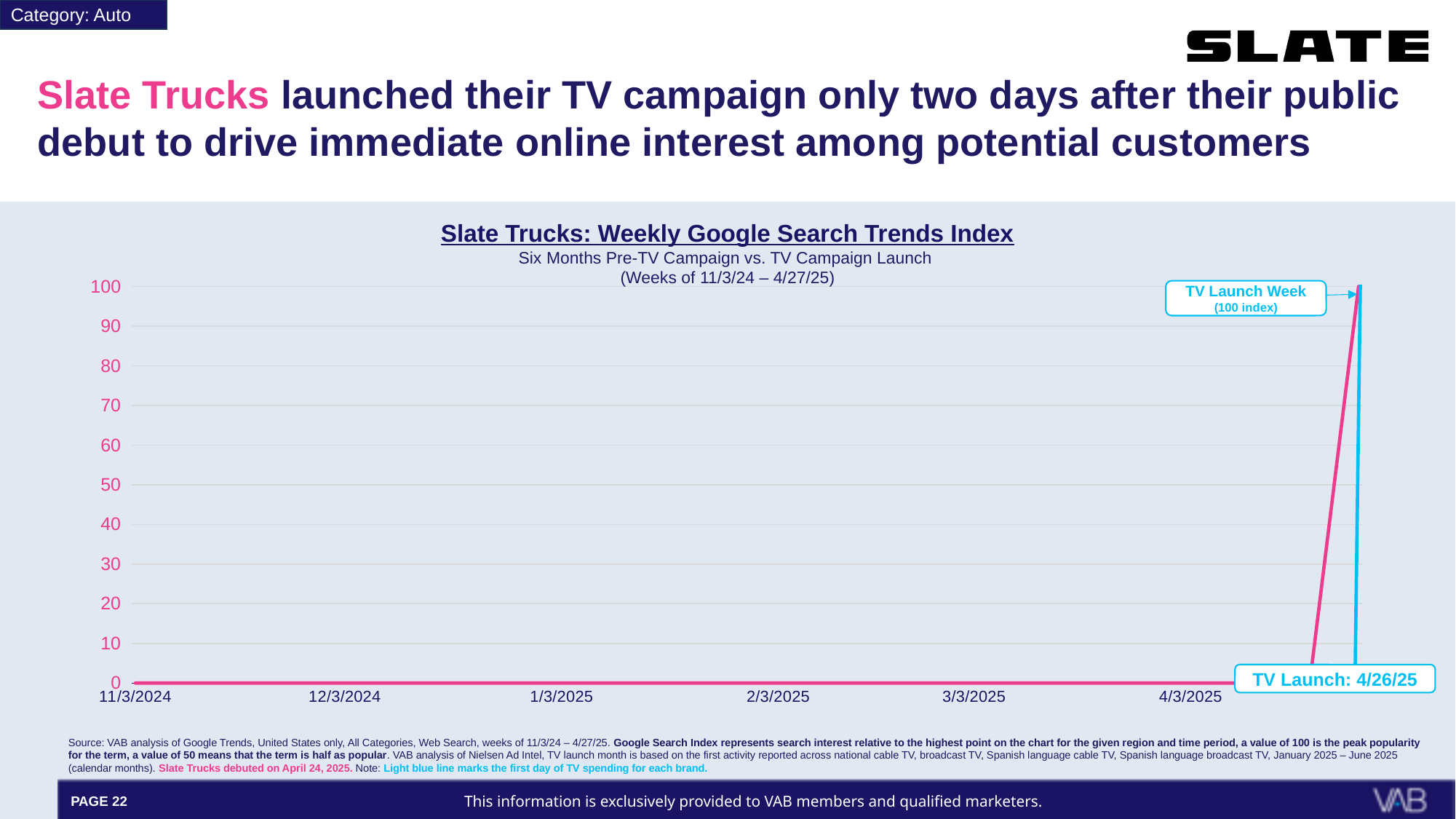
Which week has the highest search trends index value? TV Launch Week How does the search index change along the x axis from 11/3/2024 to the end of the period? flat at 0, then rises sharply to 100 at the end What is the title of the chart? Slate Trucks: Weekly Google Search Trends Index What is the search trends index value for the week of 12/3/2024? 0 What is the difference between the TV Launch Week index value and the value for the week of 11/3/2024? 100 How many date labels are shown on the x axis? 6 What index value does the chart reach in the TV Launch Week? 100 What kind of chart is shown on the slide? line chart Is the value for the week of 3/3/2025 greater or less than 10? less Which is larger, the index value in the TV Launch Week or the value for the week of 1/3/2025? TV Launch Week Is the value for the week of 2/3/2025 greater or less than 50? less What date does the chart annotation give for the TV launch? 4/26/25